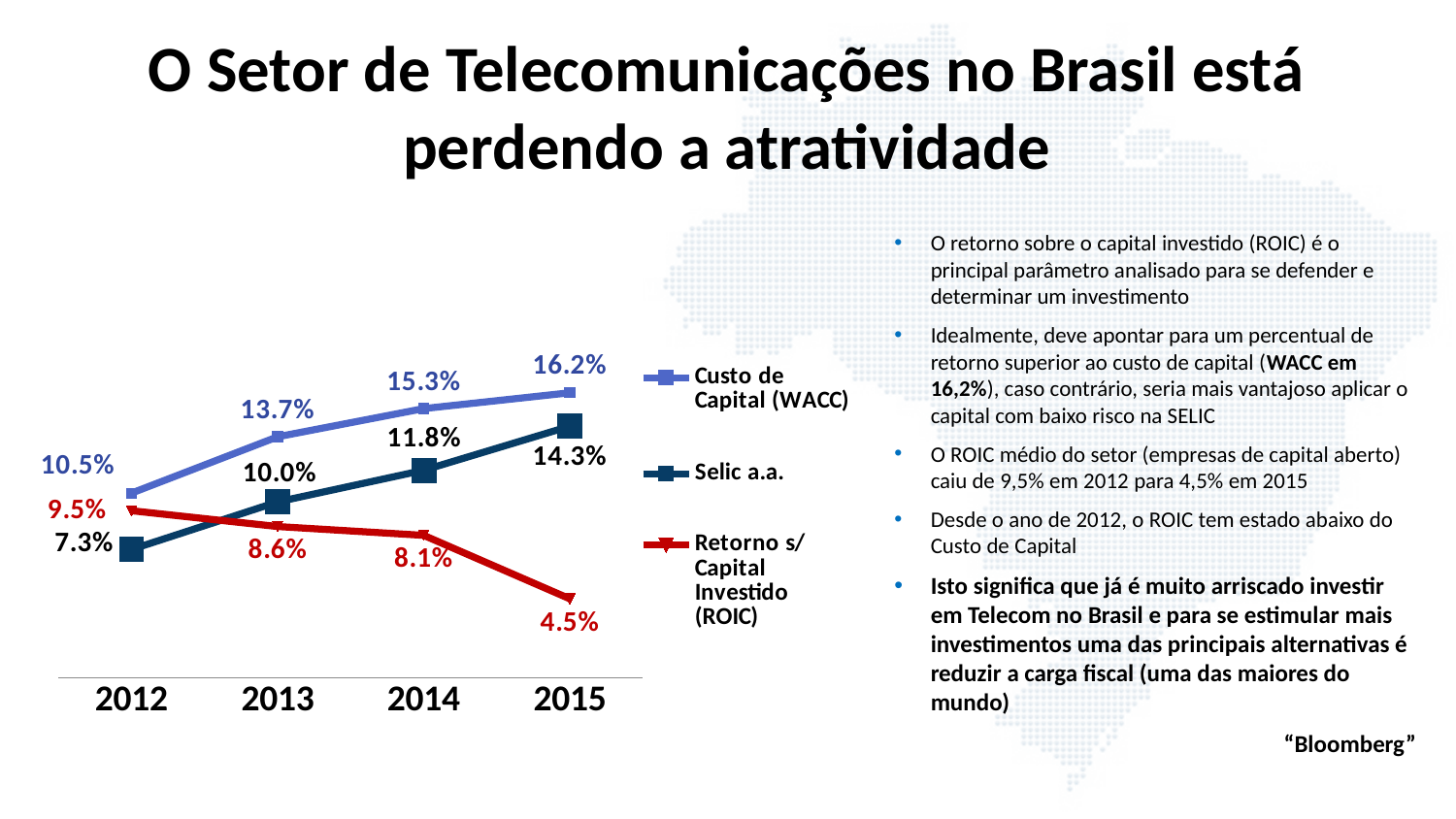
In which year is Retorno s/ Capital Investido (ROIC) lowest? 2015 What is the value of Custo de Capital (WACC) in 2015? 16.2% What type of chart is shown on the slide? line chart Which is larger in 2012: Selic a.a. or Retorno s/ Capital Investido (ROIC)? Retorno s/ Capital Investido (ROIC) What is the value of Retorno s/ Capital Investido (ROIC) in 2014? 8.1% In which year is Custo de Capital (WACC) highest? 2015 How many series does the chart legend list? 3 What is the difference between Custo de Capital (WACC) and Retorno s/ Capital Investido (ROIC) in 2015? 11.7% Does Retorno s/ Capital Investido (ROIC) rise or fall from 2012 to 2015? fall What colour is the line for Selic a.a.? dark blue What is the value of Selic a.a. in 2013? 10.0% How many years are shown on the x axis of the chart? 4